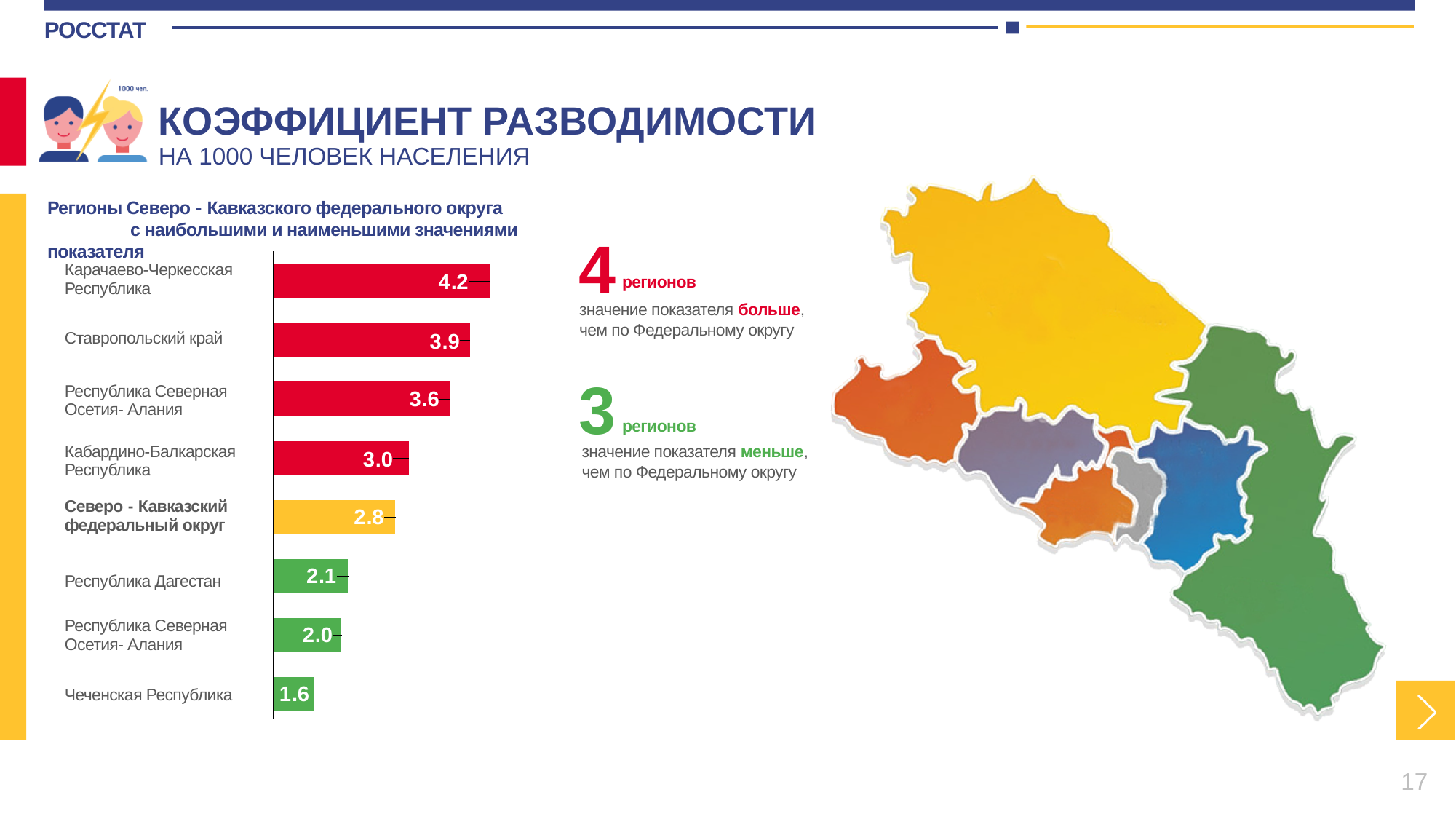
Which category has the lowest value in the chart? Чеченская Республика Which category has the highest value in the chart? Карачаево-Черкесская Республика What is the difference between the values for Карачаево-Черкесская Республика and Чеченская Республика? 2.6 What is the value shown for Чеченская Республика? 1.6 How many bars are shown in the chart? 8 What is the value shown for Ставропольский край? 3.9 What is the divorce rate value for Карачаево-Черкесская Республика? 4.2 What type of chart is shown on the slide? Bar chart Which is larger: the value for Кабардино-Балкарская Республика or for Республика Дагестан? Кабардино-Балкарская Республика What colour is the bar for Северо-Кавказский федеральный округ? Yellow What is the value shown for Северо-Кавказский федеральный округ? 2.8 What is the value shown for Республика Дагестан? 2.1